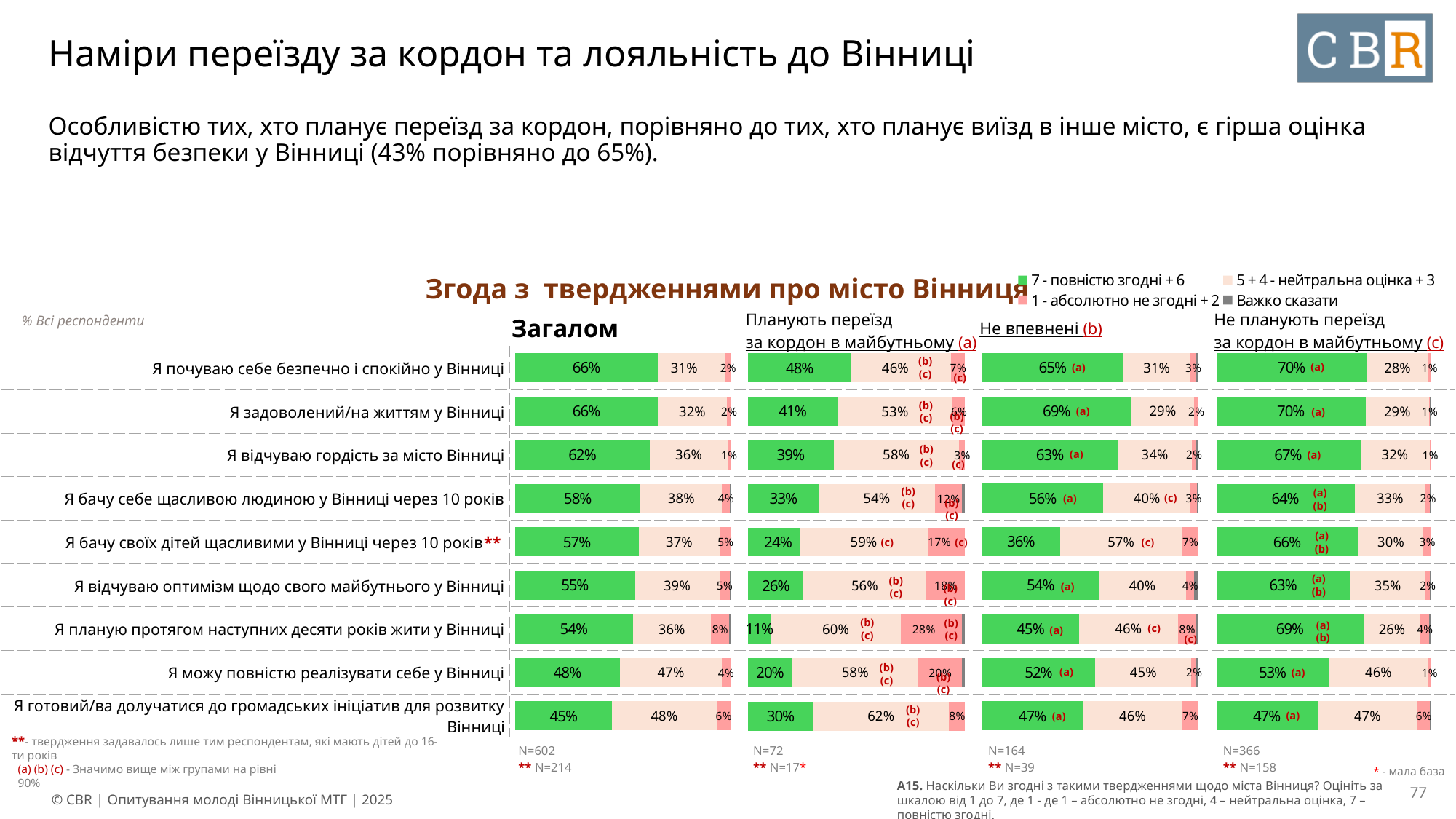
In the 'Не впевнені (b)' chart, what percentage agree (7 + 6) with 'Я бачу своїх дітей щасливими у Вінниці через 10 років'? 36% In the 'Планують переїзд за кордон в майбутньому (a)' chart, what percentage agree (7 + 6) with 'Я планую протягом наступних десяти років жити у Вінниці'? 11% In the 'Не планують переїзд за кордон в майбутньому (c)' chart, what percentage disagree (1 + 2) with 'Я планую протягом наступних десяти років жити у Вінниці'? 4% In the 'Загалом' chart, what is the difference in agreement (7 + 6) between 'Я почуваю себе безпечно і спокійно у Вінниці' and 'Я готовий/ва долучатися до громадських ініціатив для розвитку Вінниці'? 21 percentage points In the 'Планують переїзд за кордон в майбутньому (a)' chart, which statement has the lowest share of agreement (7 + 6)? Я планую протягом наступних десяти років жити у Вінниці For the statement 'Я почуваю себе безпечно і спокійно у Вінниці', which group has the higher agreement (7 + 6): 'Планують переїзд за кордон в майбутньому (a)' or 'Не впевнені (b)'? Не впевнені (b) How many series does the legend list? 4 What type of chart is used on this slide? Stacked bar chart In the 'Планують переїзд за кордон в майбутньому (a)' chart, what is the neutral (5 + 4 + 3) share for 'Я готовий/ва долучатися до громадських ініціатив для розвитку Вінниці'? 62% In the 'Загалом' chart, what percentage agree (7 + 6) with the statement 'Я почуваю себе безпечно і спокійно у Вінниці'? 66% How many statements are shown in each of the bar charts? 9 In the 'Загалом' chart, which statement has the lowest share of agreement (7 + 6)? Я готовий/ва долучатися до громадських ініціатив для розвитку Вінниці